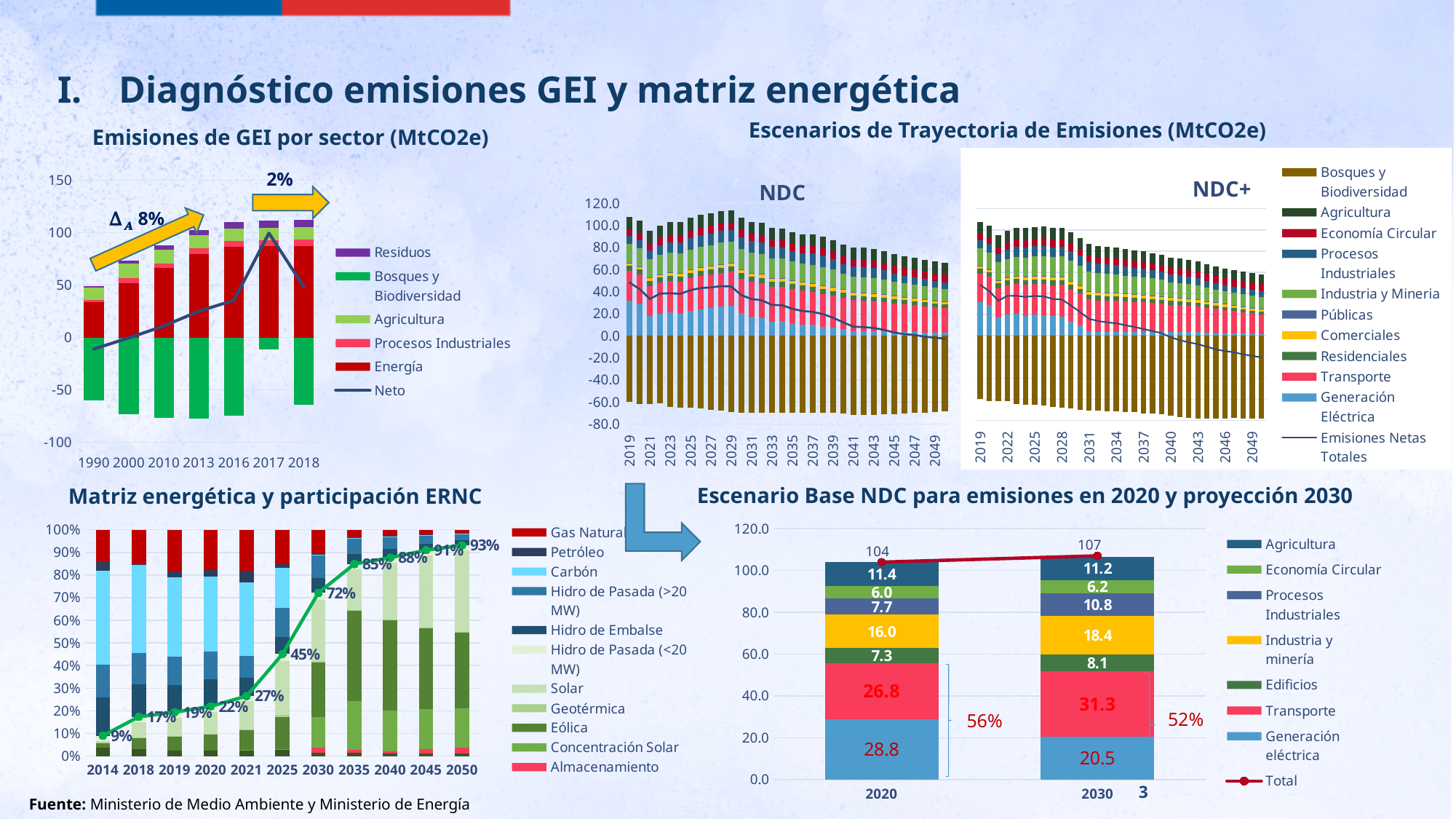
In the 'Escenario Base NDC para emisiones en 2020 y proyección 2030' chart, what is the difference between the Transporte values for 2030 and 2020? 4.5 In the 'Matriz energética y participación ERNC' chart, what is the ERNC share shown for 2030? 72% In the 'Escenario Base NDC para emisiones en 2020 y proyección 2030' chart, how many entries does the legend list? 8 In the 'Escenario Base NDC para emisiones en 2020 y proyección 2030' chart, which sector has the smallest value in 2020? Economía Circular In the 'Matriz energética y participación ERNC' chart, does the ERNC share line rise or fall from 2014 to 2050? rise In the 'Escenario Base NDC para emisiones en 2020 y proyección 2030' chart, what is the value for Transporte in 2030? 31.3 In the 'Escenario Base NDC para emisiones en 2020 y proyección 2030' chart, what is the total for 2030? 107 What kind of chart is the 'Emisiones de GEI por sector (MtCO2e)' chart? stacked bar chart with a line In the 'Emisiones de GEI por sector (MtCO2e)' chart, how many years are shown on the x axis? 7 In the 'Escenario Base NDC para emisiones en 2020 y proyección 2030' chart, what is the value for Generación eléctrica in 2020? 28.8 In the 'Matriz energética y participación ERNC' chart, how many years are shown on the x axis? 11 In the 'Escenario Base NDC para emisiones en 2020 y proyección 2030' chart, which is larger: Generación eléctrica in 2020 or Generación eléctrica in 2030? 2020